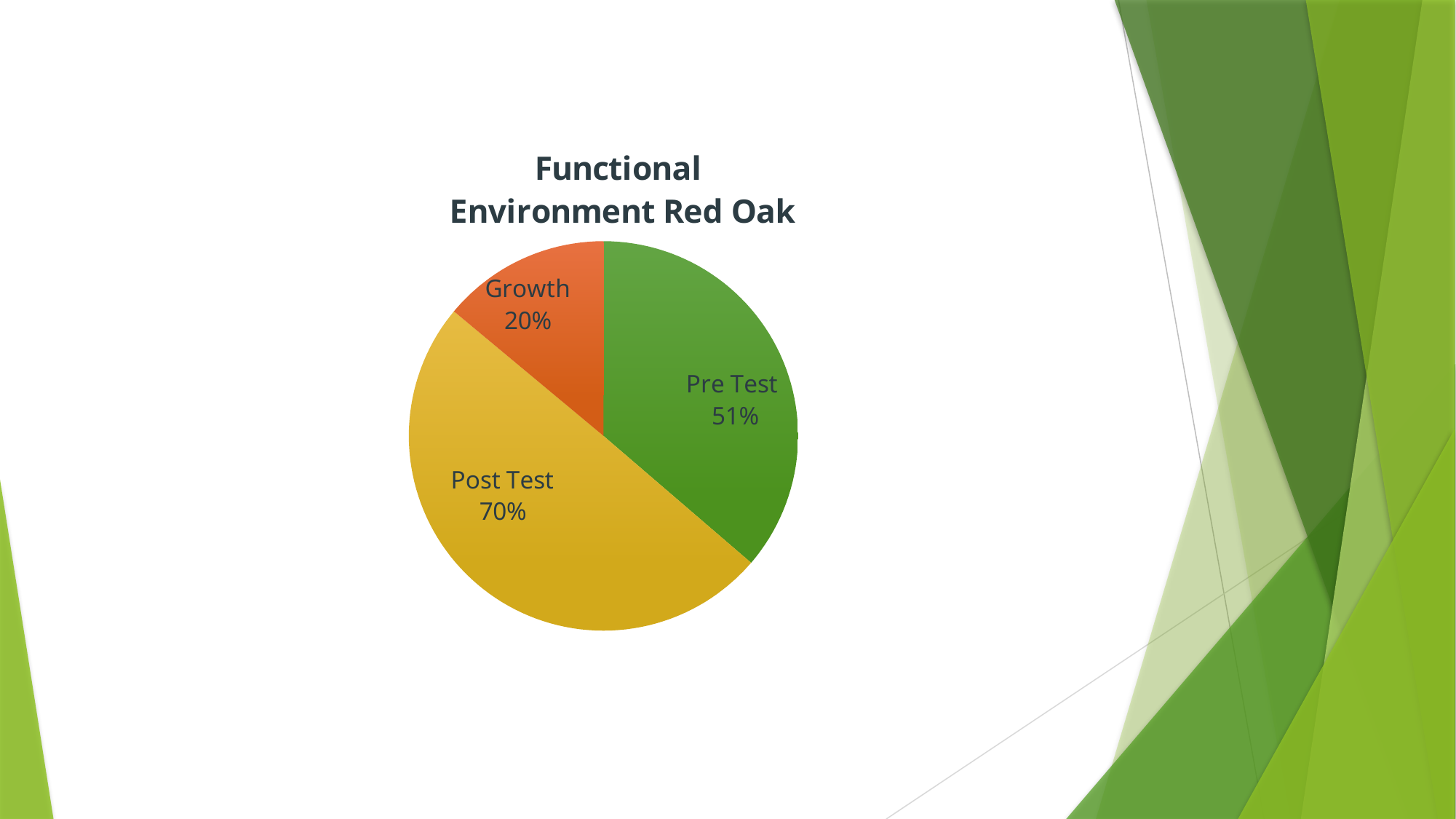
What value is shown for Growth in the Functional Environment Red Oak chart? 20% How many slices does the Functional Environment Red Oak pie chart have? 3 What is the difference between the Post Test and Pre Test values in the Functional Environment Red Oak chart? 19% Which is larger in the Functional Environment Red Oak chart, Pre Test or Growth? Pre Test What kind of chart is shown on the slide? Pie chart What value is shown for Post Test in the Functional Environment Red Oak chart? 70% Which slice has the highest value in the Functional Environment Red Oak chart? Post Test What colour is the Post Test slice in the Functional Environment Red Oak chart? Yellow What is the title of the chart on the slide? Functional Environment Red Oak Which slice has the lowest value in the Functional Environment Red Oak chart? Growth What value is shown for Pre Test in the Functional Environment Red Oak chart? 51%